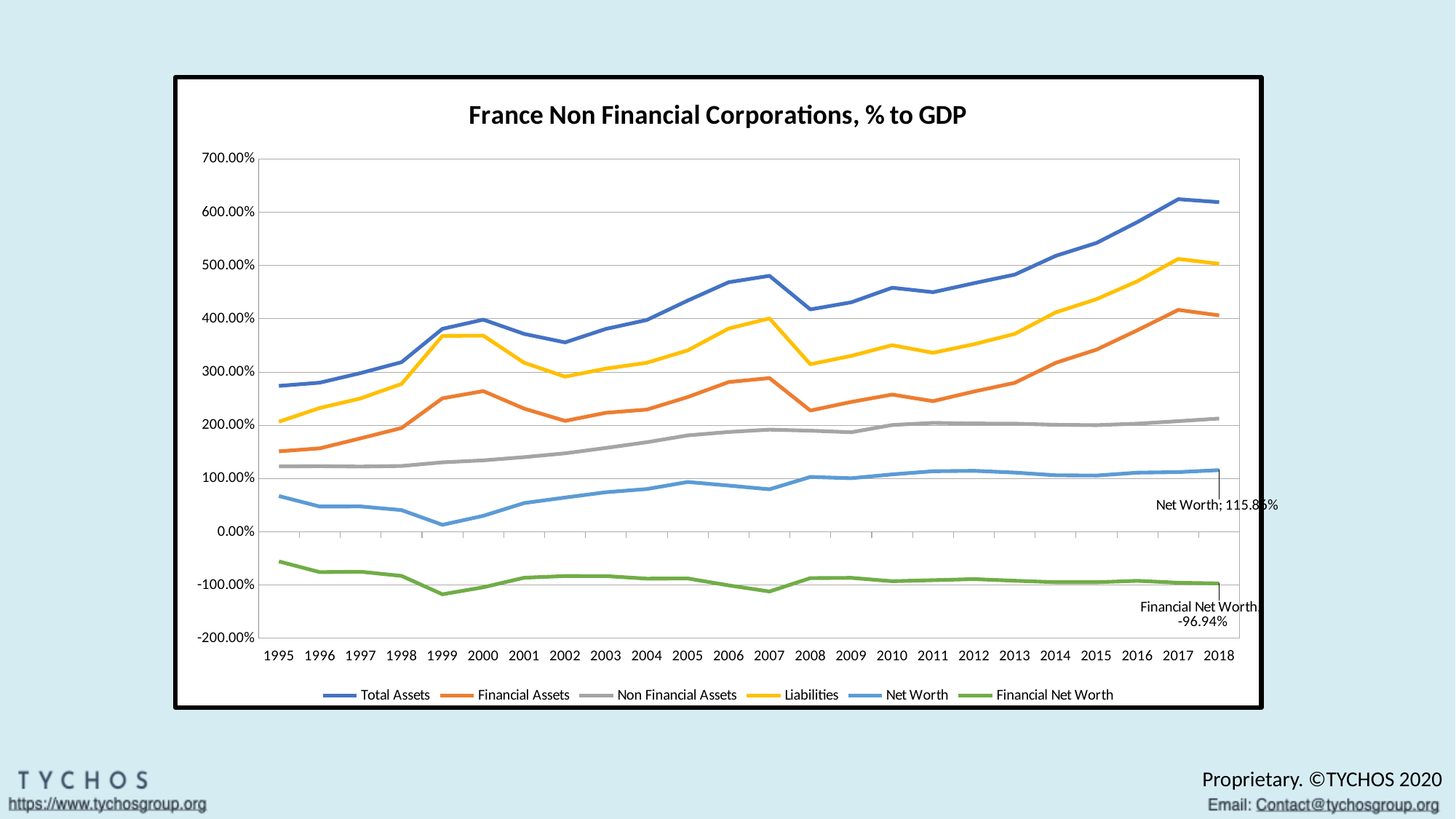
Which series has the lowest value in 2018? Financial Net Worth What is the value of Financial Net Worth in 2018? -96.94% Is the value for Total Assets in 2017 greater or less than 600.00%? greater In 2010, which is larger: Liabilities or Financial Assets? Liabilities Is the value for Net Worth in 1999 greater or less than 100.00%? less Which series has the highest value in 2018? Total Assets Does Total Assets generally rise or fall from 1995 to 2018? rise What type of chart is shown on the slide? line chart In which year does Net Worth reach its lowest value? 1999 What is the title of the chart? France Non Financial Corporations, % to GDP How many series does the legend list? 6 How many years are shown on the x axis? 24